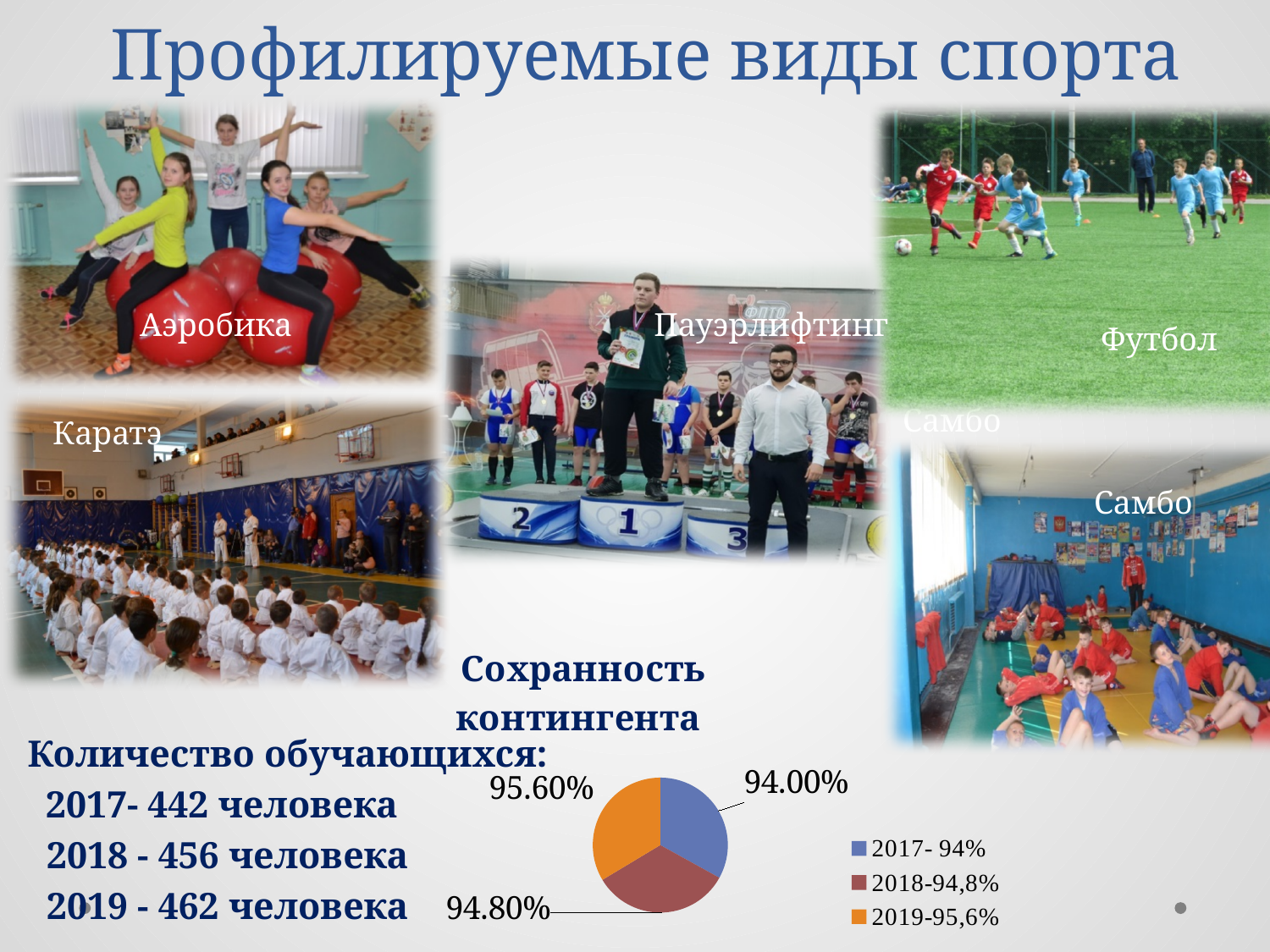
What is the difference between the 2019 value and the 2017 value in the pie chart? 1.60% What is the title of the pie chart? Сохранность контингента What value is labelled on the pie chart for 2017? 94.00% Which year has the lowest value in the pie chart? 2017 What value is labelled on the pie chart for 2018? 94.80% Which year has the highest value in the pie chart? 2019 What colour is the slice for 2019 in the pie chart? orange Which is larger in the pie chart, the value for 2018 or the value for 2017? 2018 What value is labelled on the pie chart for 2019? 95.60% How many entries does the legend of the pie chart list? 3 How many slices does the pie chart have? 3 What kind of chart is shown on the slide? pie chart